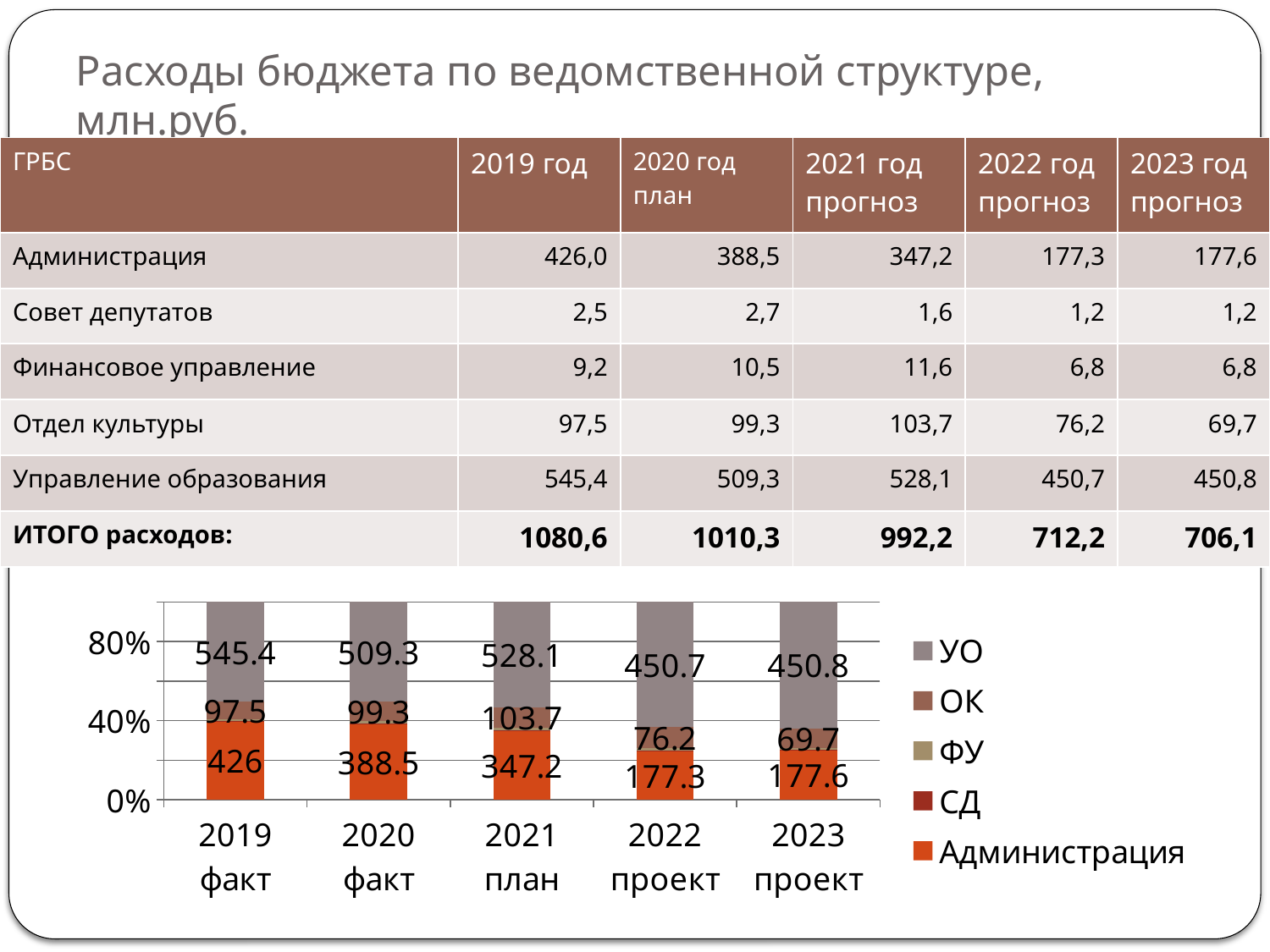
In the chart, what is the value labelled for УО in 2019 факт? 545.4 In the chart, what is the value labelled for Администрация in 2021 план? 347.2 In the chart, which is larger: the ОК value for 2021 план or for 2020 факт? 2021 план How many series does the chart legend list? 5 Which series is shown in orange in the chart legend? Администрация In the chart, what is the difference between the Администрация values for 2019 факт and 2020 факт? 37.5 What kind of chart is shown at the bottom of the slide? stacked bar chart How many categories are shown on the x axis of the chart? 5 In the chart, do the labelled Администрация values rise or fall from 2019 факт to 2022 проект? fall In the chart, which category has the lowest labelled value for ОК? 2023 проект In the chart, which category has the highest labelled value for УО? 2019 факт In the chart, what is the value labelled for ОК in 2022 проект? 76.2